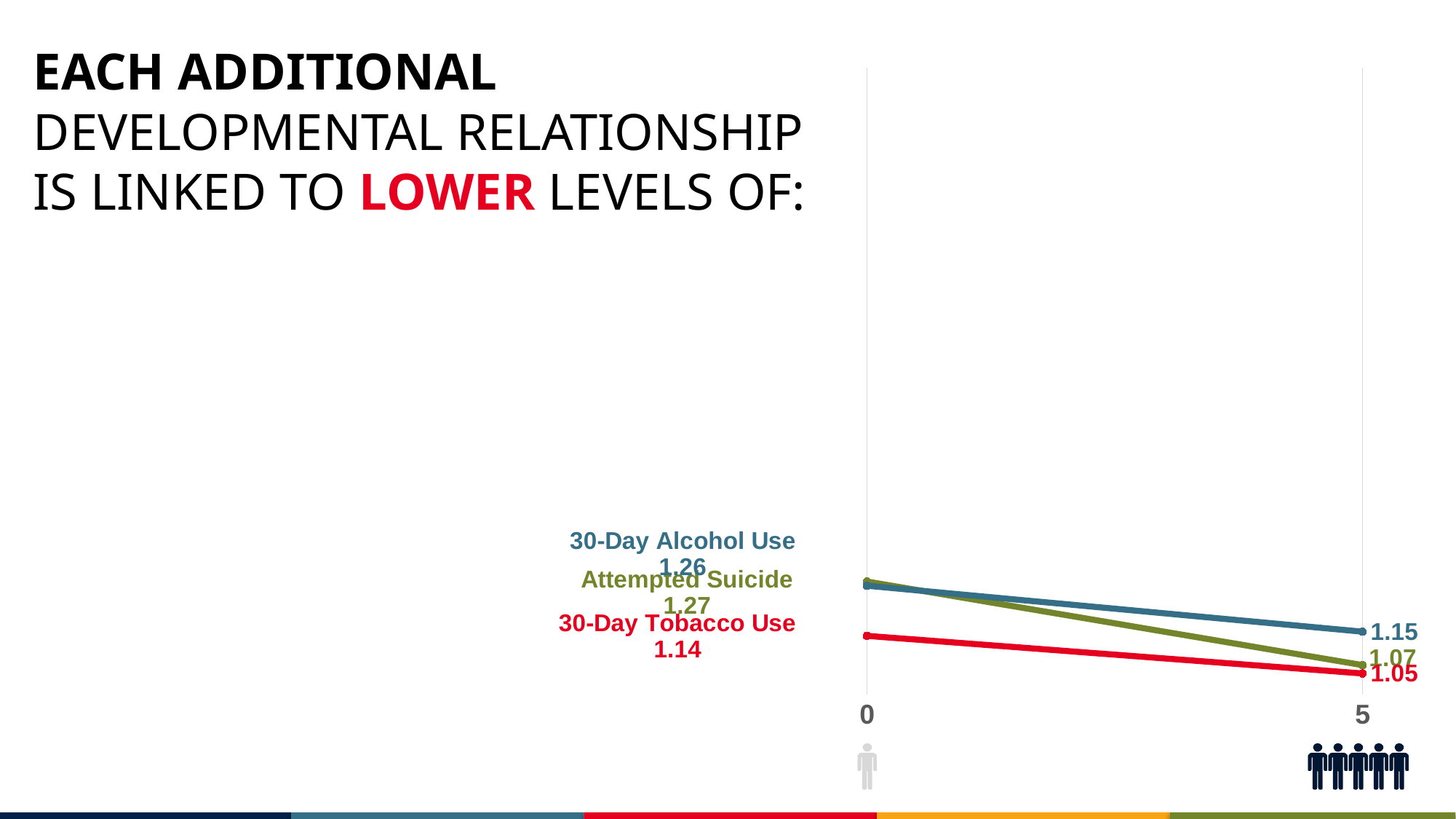
At 5 developmental relationships, which is larger: the value for Attempted Suicide or the value for 30-Day Tobacco Use? Attempted Suicide What is the value for Attempted Suicide at 5 developmental relationships? 1.07 What kind of chart is shown on the slide? line chart How many series are plotted on the chart? 3 Which series has the highest value at 5 developmental relationships? 30-Day Alcohol Use What is the value for 30-Day Alcohol Use at 5 developmental relationships? 1.15 What is the value for 30-Day Tobacco Use at 0 developmental relationships? 1.14 What is the value for Attempted Suicide at 0 developmental relationships? 1.27 What is the value for 30-Day Tobacco Use at 5 developmental relationships? 1.05 Do the values for Attempted Suicide rise or fall from 0 to 5 developmental relationships? fall Which series has the lowest value at 5 developmental relationships? 30-Day Tobacco Use What is the difference between the 30-Day Alcohol Use value and the 30-Day Tobacco Use value at 5 developmental relationships? 0.10